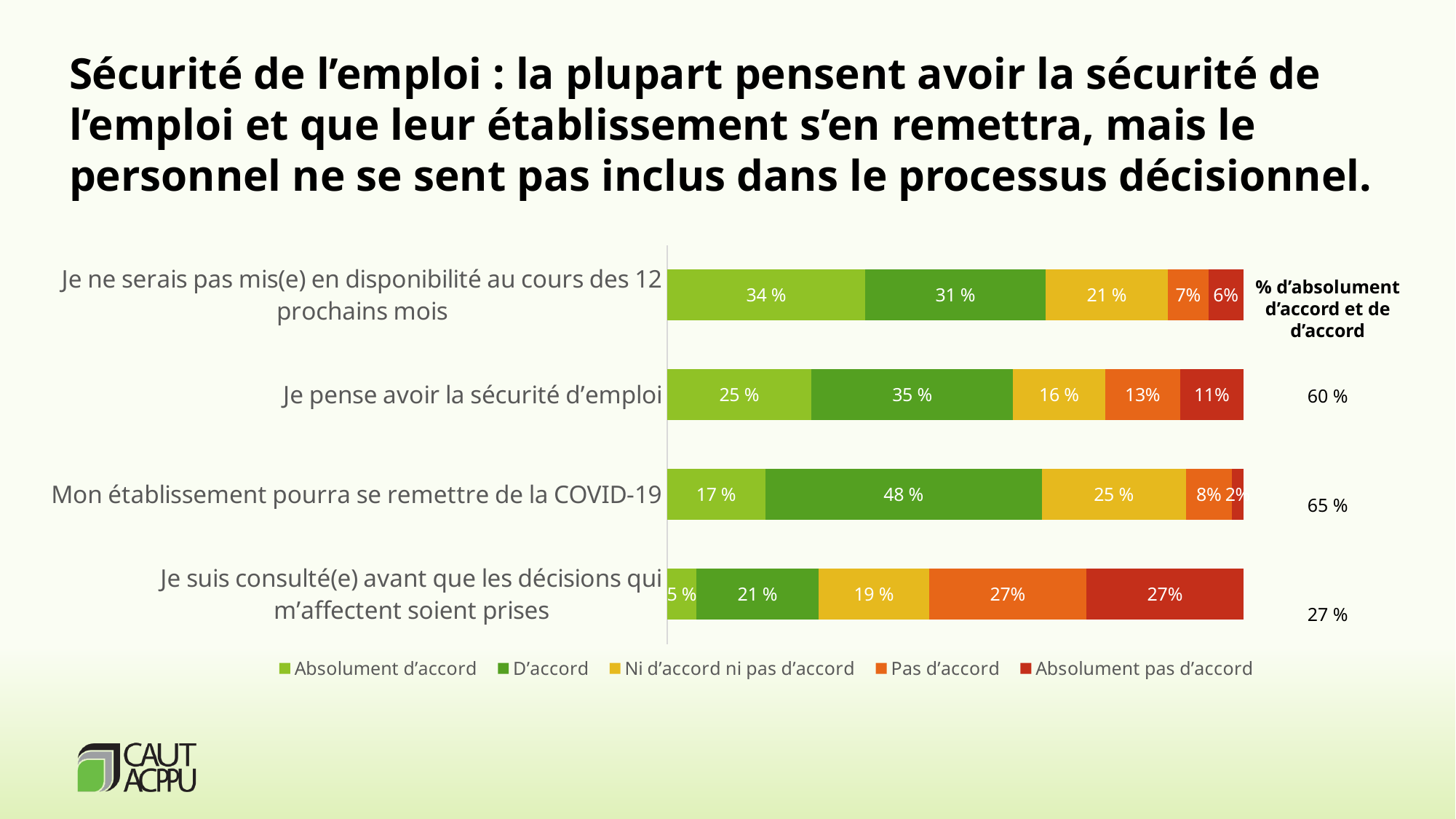
What is the "Absolument d'accord" value for "Je pense avoir la sécurité d'emploi"? 25 % How many percentage points higher is the "Absolument d'accord" value for "Je ne serais pas mis(e) en disponibilité au cours des 12 prochains mois" than for "Je pense avoir la sécurité d'emploi"? 9 % Which statement has a larger "Pas d'accord" share: "Je pense avoir la sécurité d'emploi" or "Mon établissement pourra se remettre de la COVID-19"? Je pense avoir la sécurité d'emploi What is the combined percentage of "Absolument d'accord" and "D'accord" for "Je pense avoir la sécurité d'emploi"? 60 % What percentage answered "Absolument pas d'accord" to "Je suis consulté(e) avant que les décisions qui m'affectent soient prises"? 27% Which statement has the lowest "Absolument d'accord" percentage? Je suis consulté(e) avant que les décisions qui m'affectent soient prises What percentage of respondents answered "D'accord" to "Mon établissement pourra se remettre de la COVID-19"? 48 % What is the "Ni d'accord ni pas d'accord" value for "Je ne serais pas mis(e) en disponibilité au cours des 12 prochains mois"? 21 % Which statement has the highest "D'accord" percentage? Mon établissement pourra se remettre de la COVID-19 How many statements are shown in the chart? 4 What kind of chart is shown on the slide? Stacked bar chart How many response categories does the legend list? 5